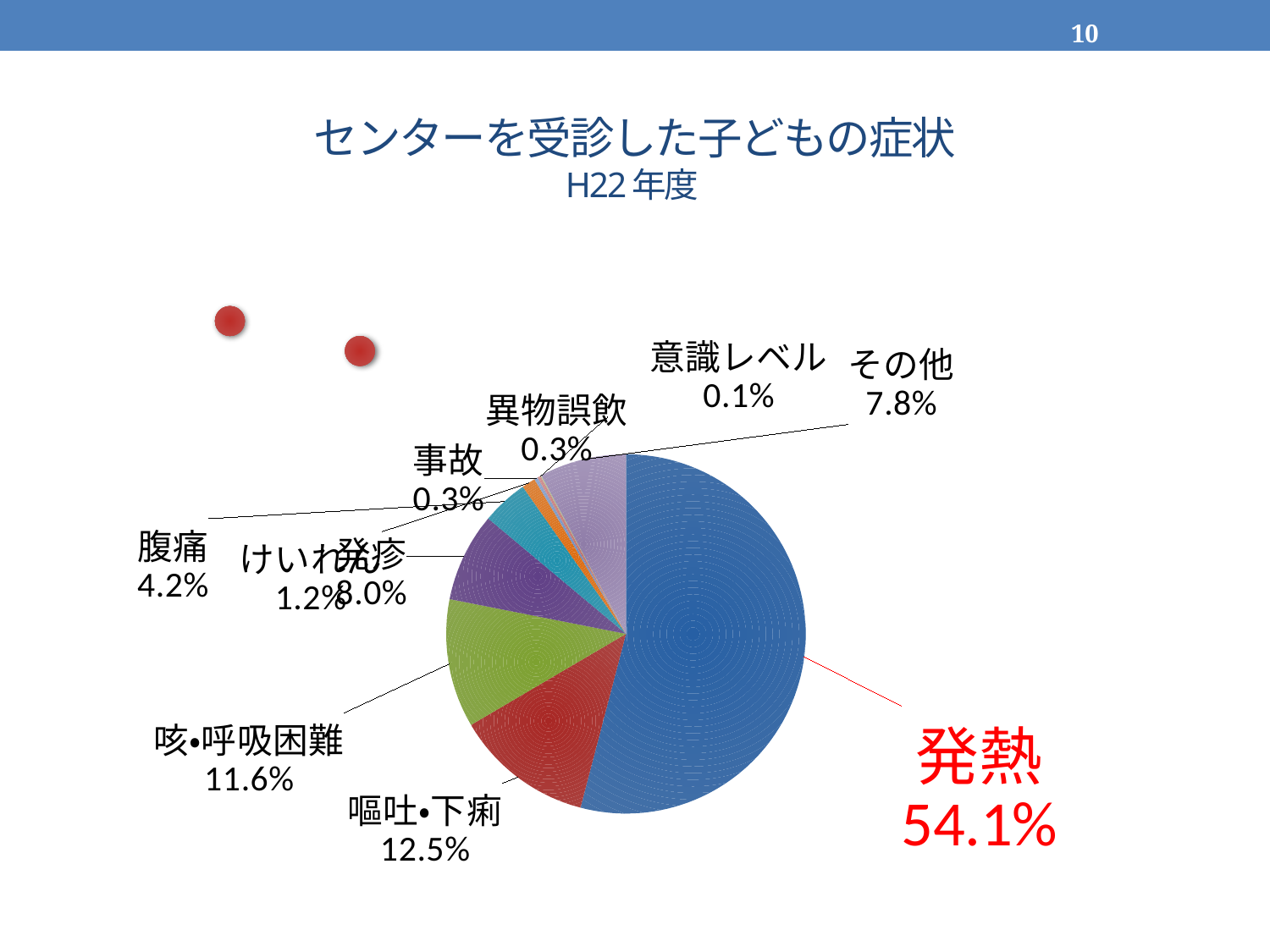
What is the value shown for 嘔吐•下痢? 12.5% How many categories are shown in the pie chart? 10 What share of the pie does 発熱 account for? 54.1% What is the value shown for その他? 7.8% What kind of chart is shown on the slide? pie chart Which is larger, the share for その他 or the share for 腹痛? その他 What is the difference between the shares of 嘔吐•下痢 and 咳•呼吸困難? 0.9% Which category has the largest share of the pie? 発熱 Which category has the smallest share of the pie? 意識レベル What is the value shown for 咳•呼吸困難? 11.6% What is the value shown for 腹痛? 4.2% What is the value shown for 意識レベル? 0.1%